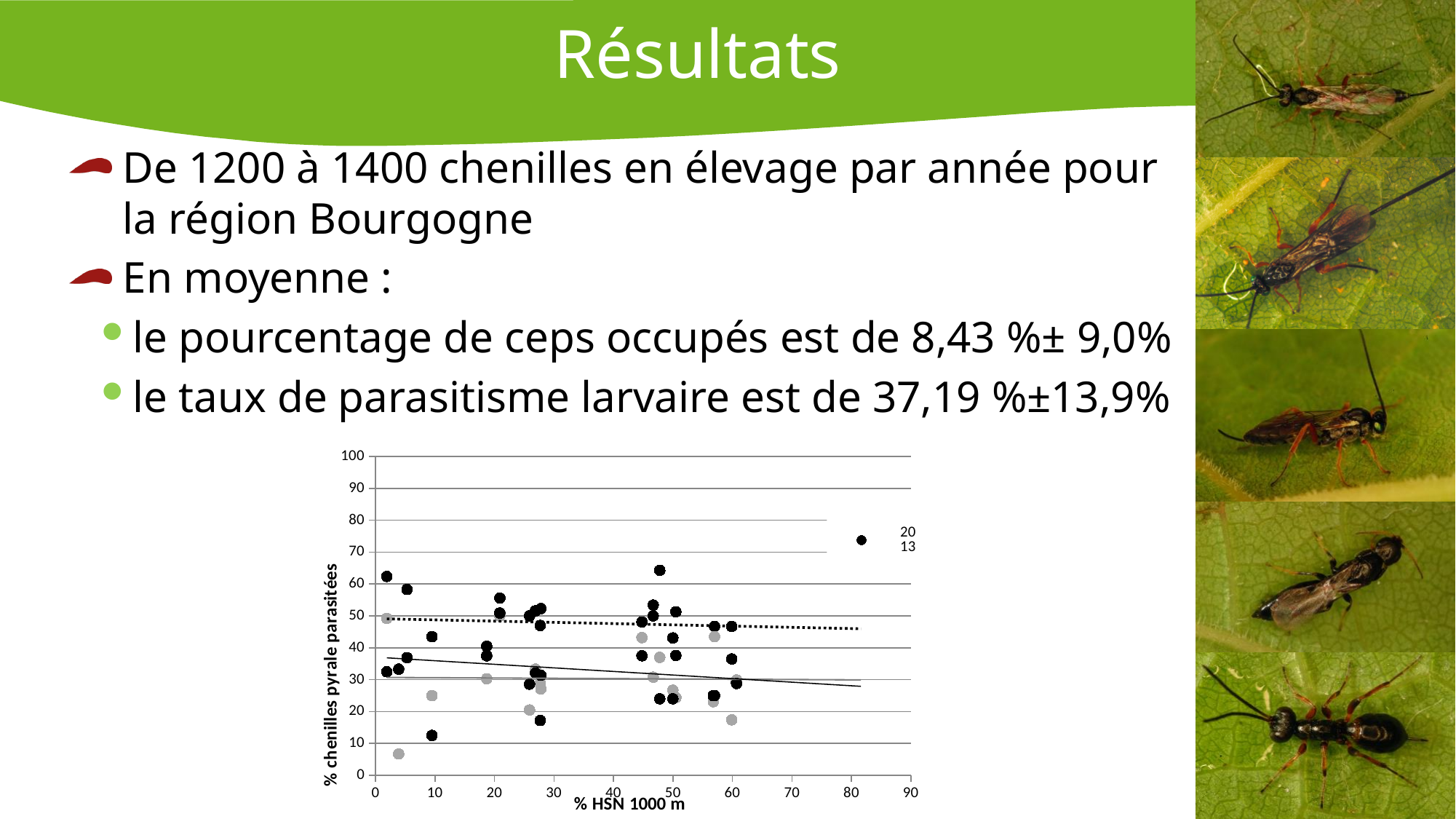
Which trend line on the chart lies higher on the y axis, the dotted line or the solid line? the dotted line Does the dotted trend line on the chart rise or fall as the x axis value increases? fall Is the value of the highest black point on the chart (at about 82 on the x axis) greater or less than 70? greater Is the value of the lowest black point on the chart (near 10 on the x axis) greater or less than 20? less What kind of chart is shown on the slide? scatter chart What is the title of the x axis of the chart? % HSN 1000 m Is the value of the lowest grey point on the chart (near 4 on the x axis) greater or less than 10? less What is the title of the y axis of the chart? % chenilles pyrale parasitées Does the solid trend line on the chart rise or fall as the x axis value increases? fall